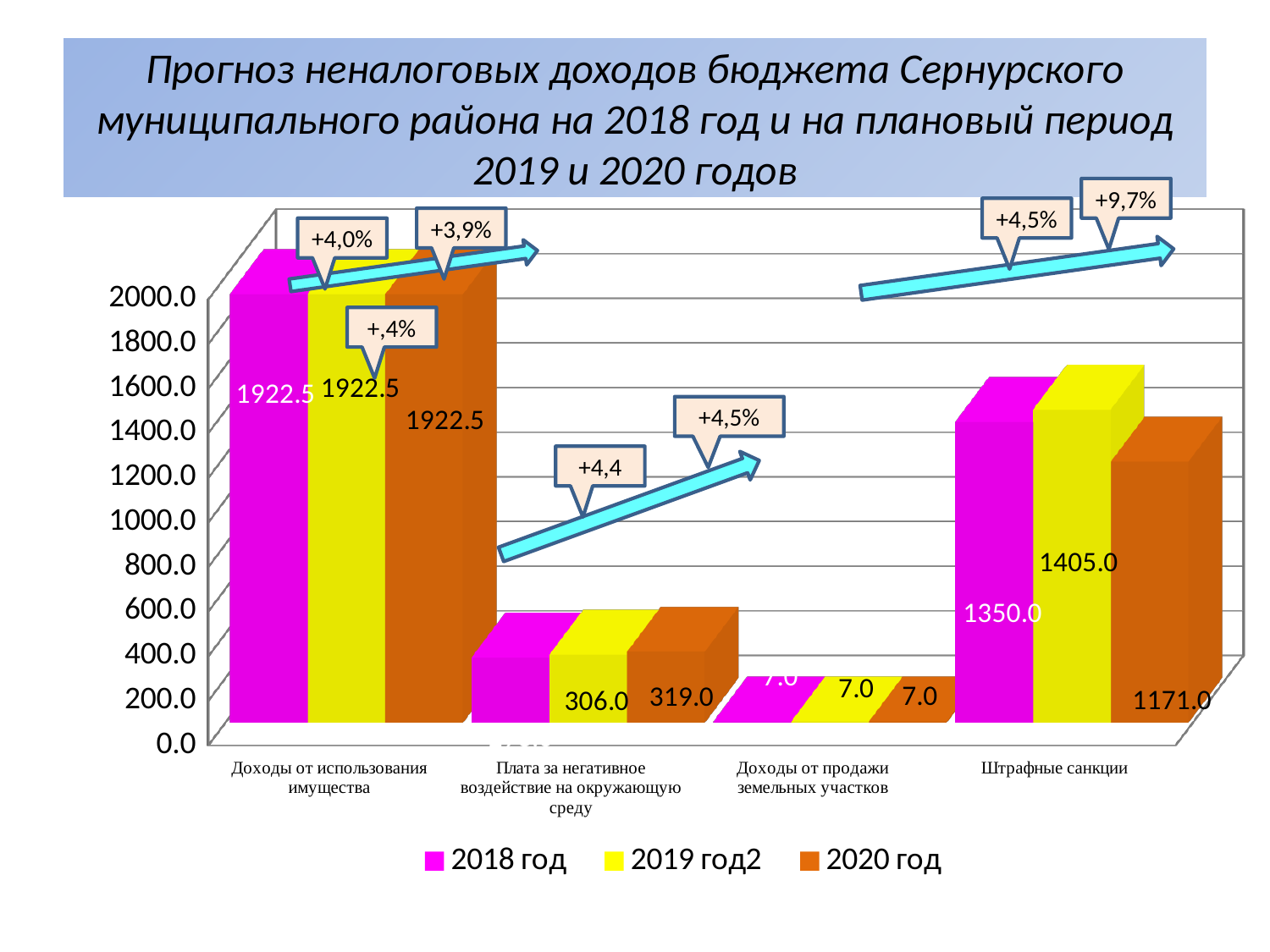
What is the difference between the 2020 год and 2019 год2 values for Плата за негативное воздействие на окружающую среду? 13.0 Which category has the highest value in the 2020 год series? Доходы от использования имущества What is the difference between the 2019 год2 and 2020 год values for Штрафные санкции? 234.0 How many series does the legend list? 3 Is the 2018 год value for Плата за негативное воздействие на окружающую среду greater or less than 600.0? less For Штрафные санкции, which series has the larger value: 2018 год or 2019 год2? 2019 год2 What kind of chart is shown on the slide? bar chart What is the value for Доходы от использования имущества in the 2019 год2 series? 1922.5 What is the value for Штрафные санкции in the 2020 год series? 1171.0 What is the value for Плата за негативное воздействие на окружающую среду in the 2020 год series? 319.0 What is the value for Штрафные санкции in the 2019 год2 series? 1405.0 Which category has the lowest value in the 2019 год2 series? Доходы от продажи земельных участков